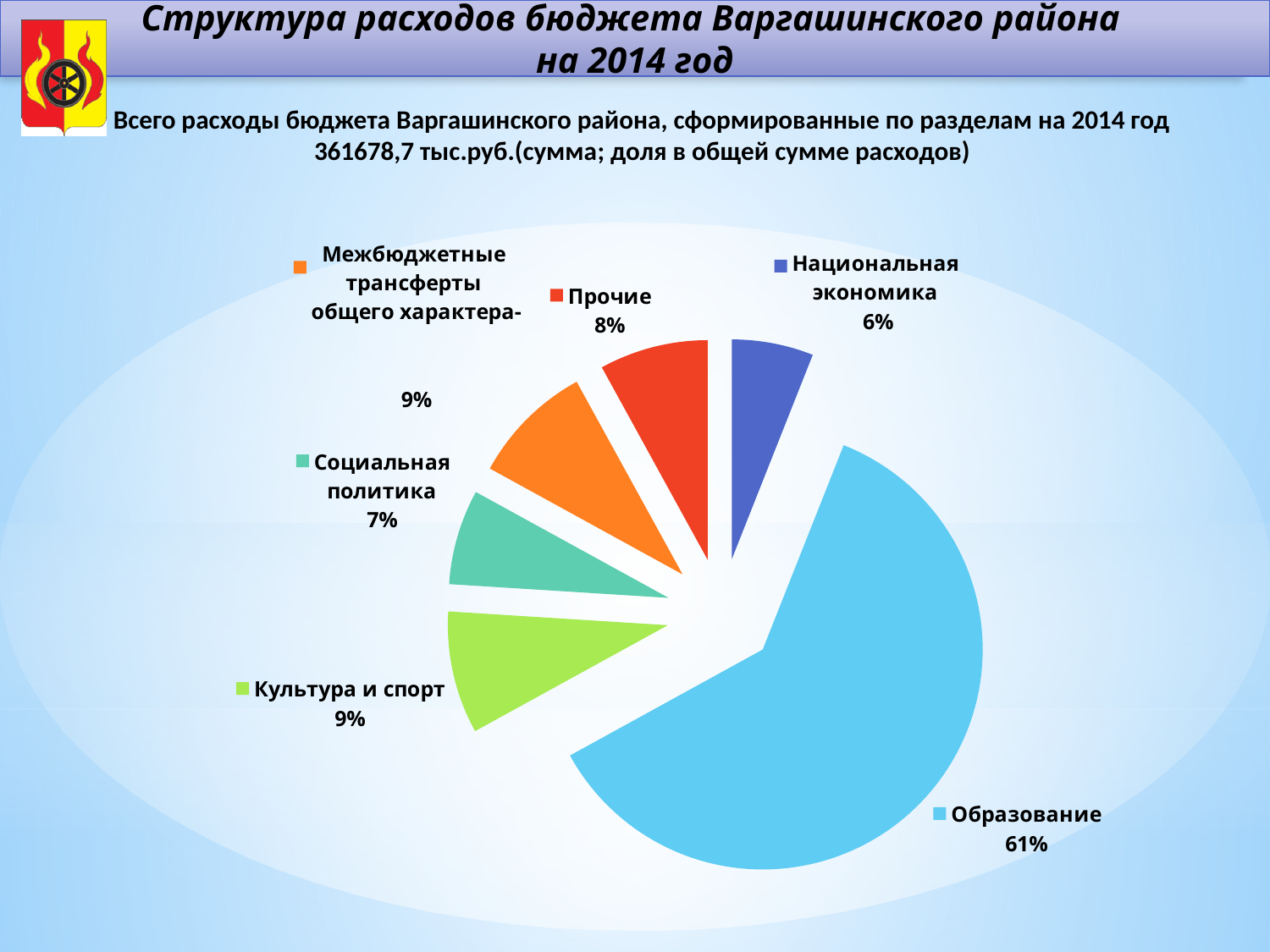
Which category has the smallest slice of the pie? Национальная экономика What share of the pie does Образование have? 61% What kind of chart is shown on the slide? pie chart What colour is the Образование slice of the pie? light blue What share of the pie does Социальная политика have? 7% What share of the pie does Национальная экономика have? 6% How many slices does the pie chart have? 6 What is the difference in percentage points between the share for Образование and the share for Культура и спорт? 52 Which category has the largest slice of the pie? Образование Which is larger, the share for Прочие or the share for Социальная политика? Прочие